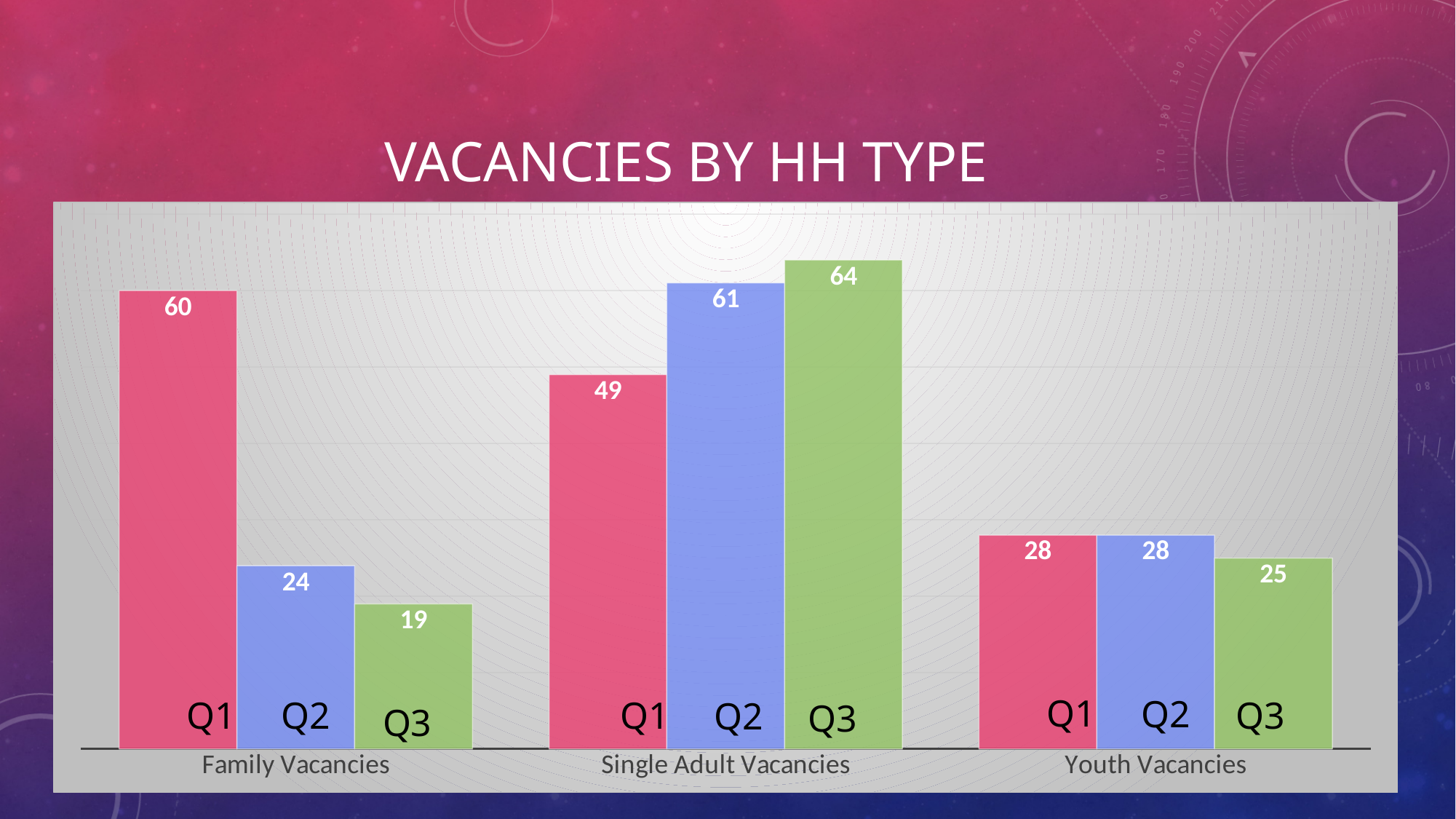
What kind of chart is shown on the slide? Bar chart How many quarters are shown for each household type? 3 What is the Q1 value for Family Vacancies? 60 What is the difference between the Q3 values for Single Adult Vacancies and Youth Vacancies? 39 Which quarter has the highest value for Single Adult Vacancies? Q3 What is the difference between the Q1 and Q3 values for Family Vacancies? 41 Which is larger: the Q1 value for Family Vacancies or the Q1 value for Single Adult Vacancies? Family Vacancies What is the Q3 value for Single Adult Vacancies? 64 What is the title of the chart? Vacancies by HH Type What is the Q2 value for Youth Vacancies? 28 How many household type categories are shown on the x axis? 3 Which quarter has the lowest value for Family Vacancies? Q3